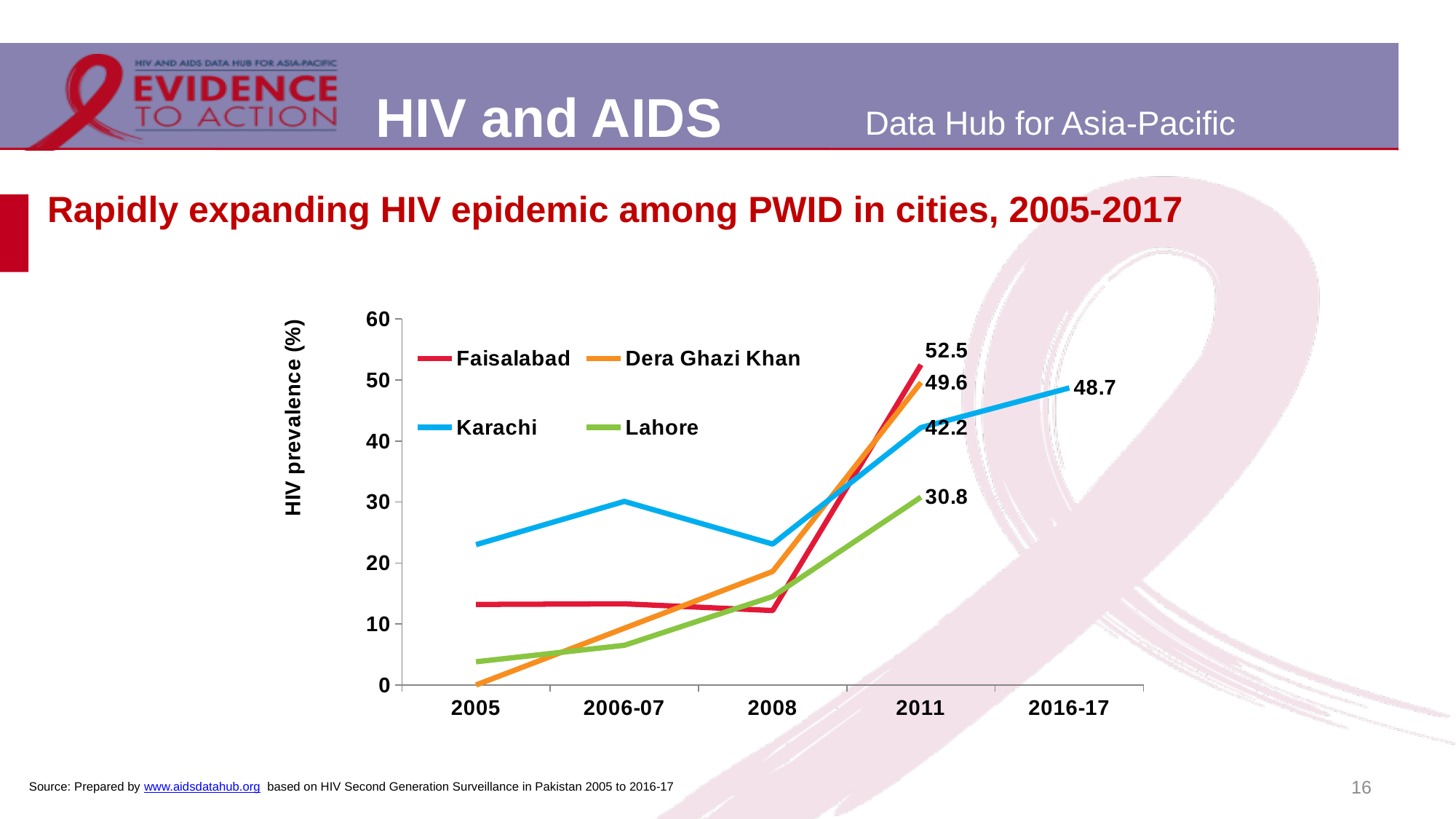
What is the HIV prevalence for Karachi in 2016-17? 48.7 What is the HIV prevalence for Lahore in 2011? 30.8 What is the difference between the 2011 values for Faisalabad and Dera Ghazi Khan? 2.9 What is the label of the y axis? HIV prevalence (%) What kind of chart is shown on the slide? line chart How many time points are shown on the x axis? 5 Which city has the highest HIV prevalence in 2011? Faisalabad How many series does the legend list? 4 By how much did Karachi's HIV prevalence change from 2011 to 2016-17? 6.5 Does the HIV prevalence for Lahore rise or fall from 2005 to 2011? rise What is the HIV prevalence for Faisalabad in 2011? 52.5 Is the value for Karachi in 2005 greater or less than 20? greater